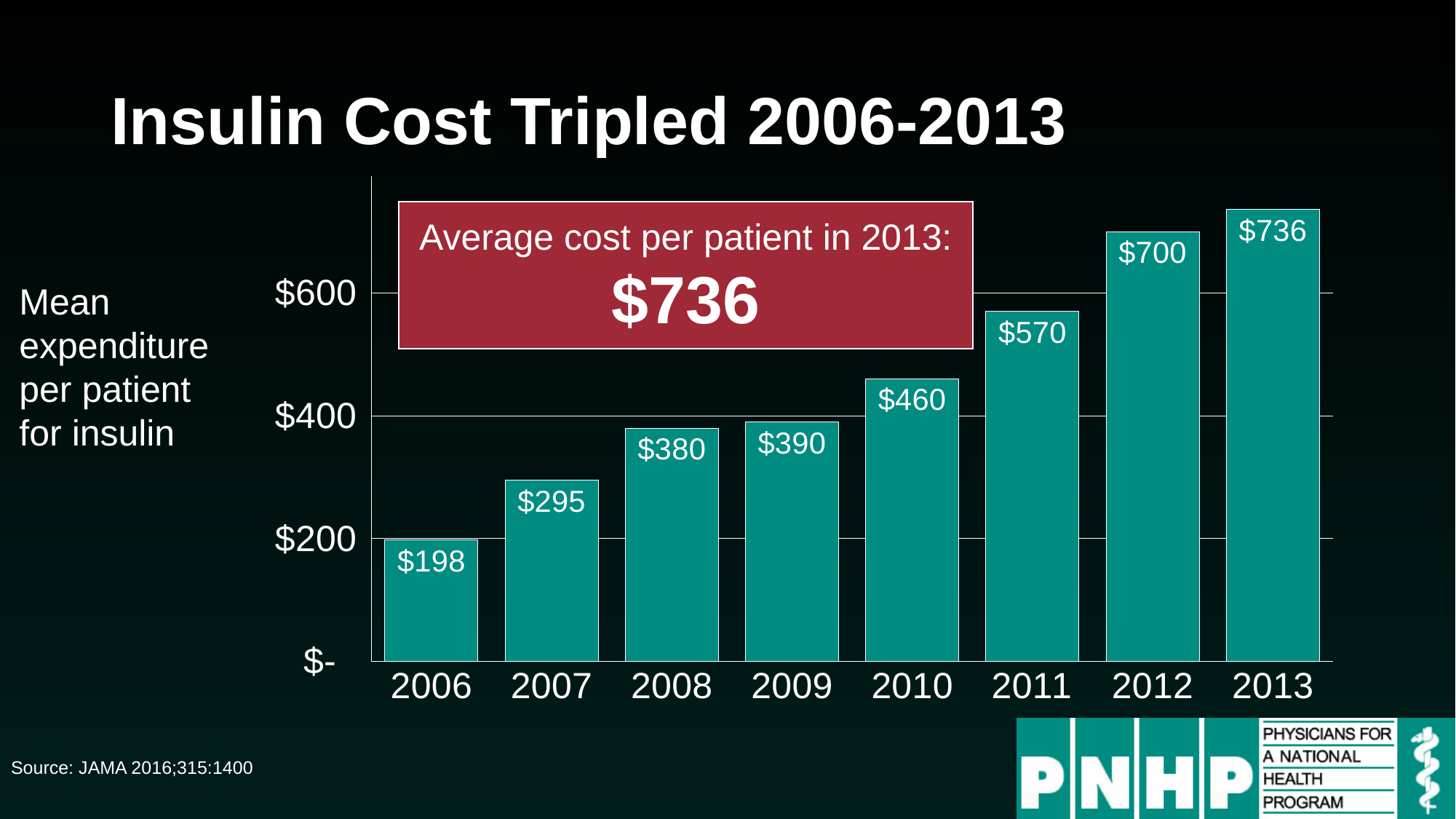
What was the mean expenditure per patient for insulin in 2012? $700 Is the value for 2009 greater or less than $400? less What is the difference between the mean expenditure per patient in 2013 and in 2006? $538 What kind of chart is shown on the slide? Bar chart How many years are shown on the x axis of the chart? 8 Which year has the highest mean expenditure per patient for insulin? 2013 What was the mean expenditure per patient for insulin in 2006? $198 Do the values rise or fall from 2006 to 2013? Rise What is the difference between the mean expenditure per patient in 2011 and in 2010? $110 What was the mean expenditure per patient for insulin in 2010? $460 Which year has the lowest mean expenditure per patient for insulin? 2006 Which year had a higher mean expenditure per patient for insulin, 2008 or 2011? 2011